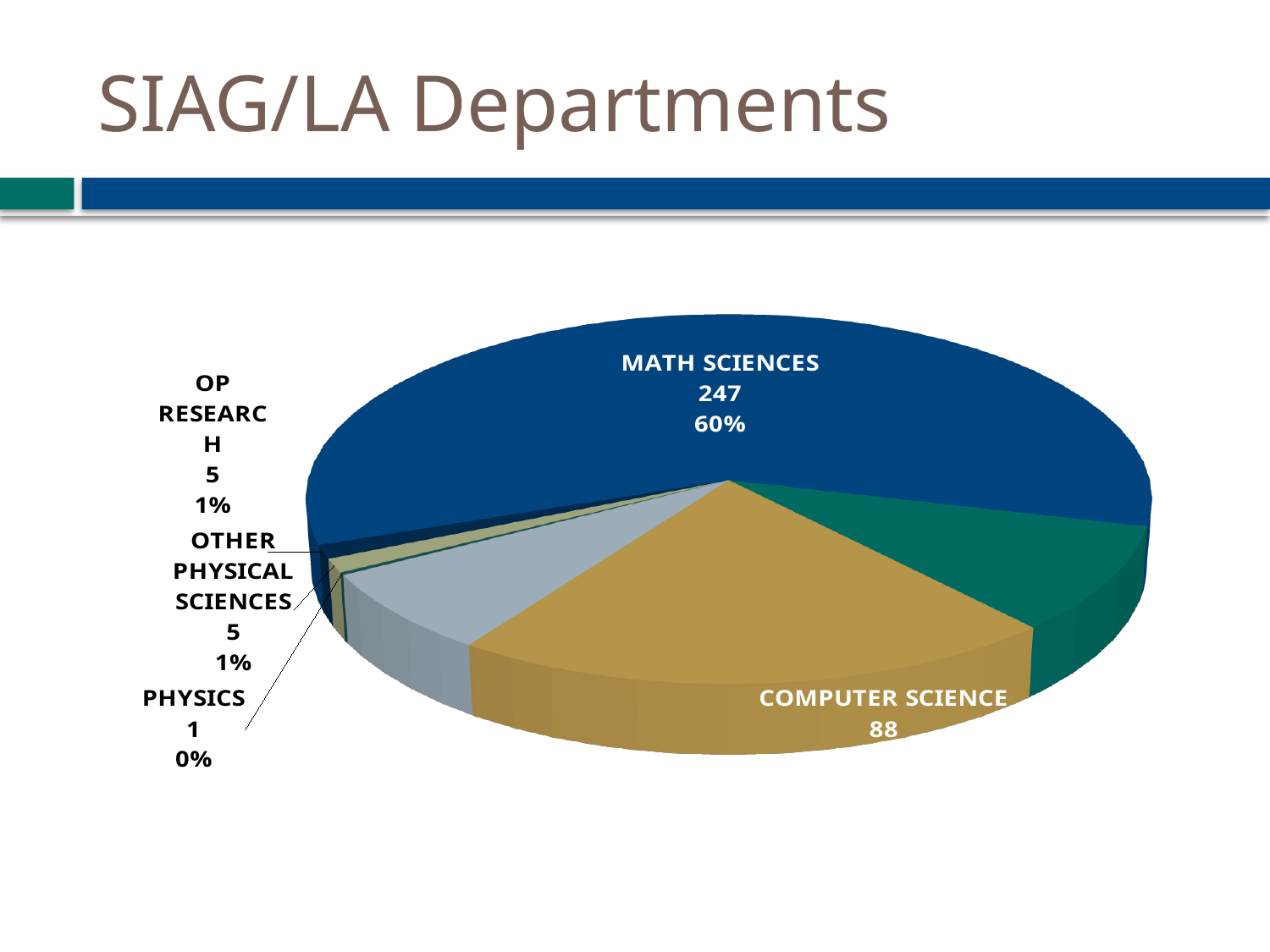
Which is larger, the COMPUTER SCIENCE slice or the OP RESEARCH slice? COMPUTER SCIENCE Which labeled department has the smallest slice? PHYSICS What value is shown for COMPUTER SCIENCE? 88 How many members are in the MATH SCIENCES slice? 247 What value is shown for OP RESEARCH? 5 What percentage share does MATH SCIENCES have? 60% Which labeled department has the largest slice? MATH SCIENCES What percentage share is shown for OTHER PHYSICAL SCIENCES? 1% What is the difference between the MATH SCIENCES value and the COMPUTER SCIENCE value? 159 What is the title of the slide containing the chart? SIAG/LA Departments What value is shown for PHYSICS? 1 What kind of chart is shown on the slide? pie chart